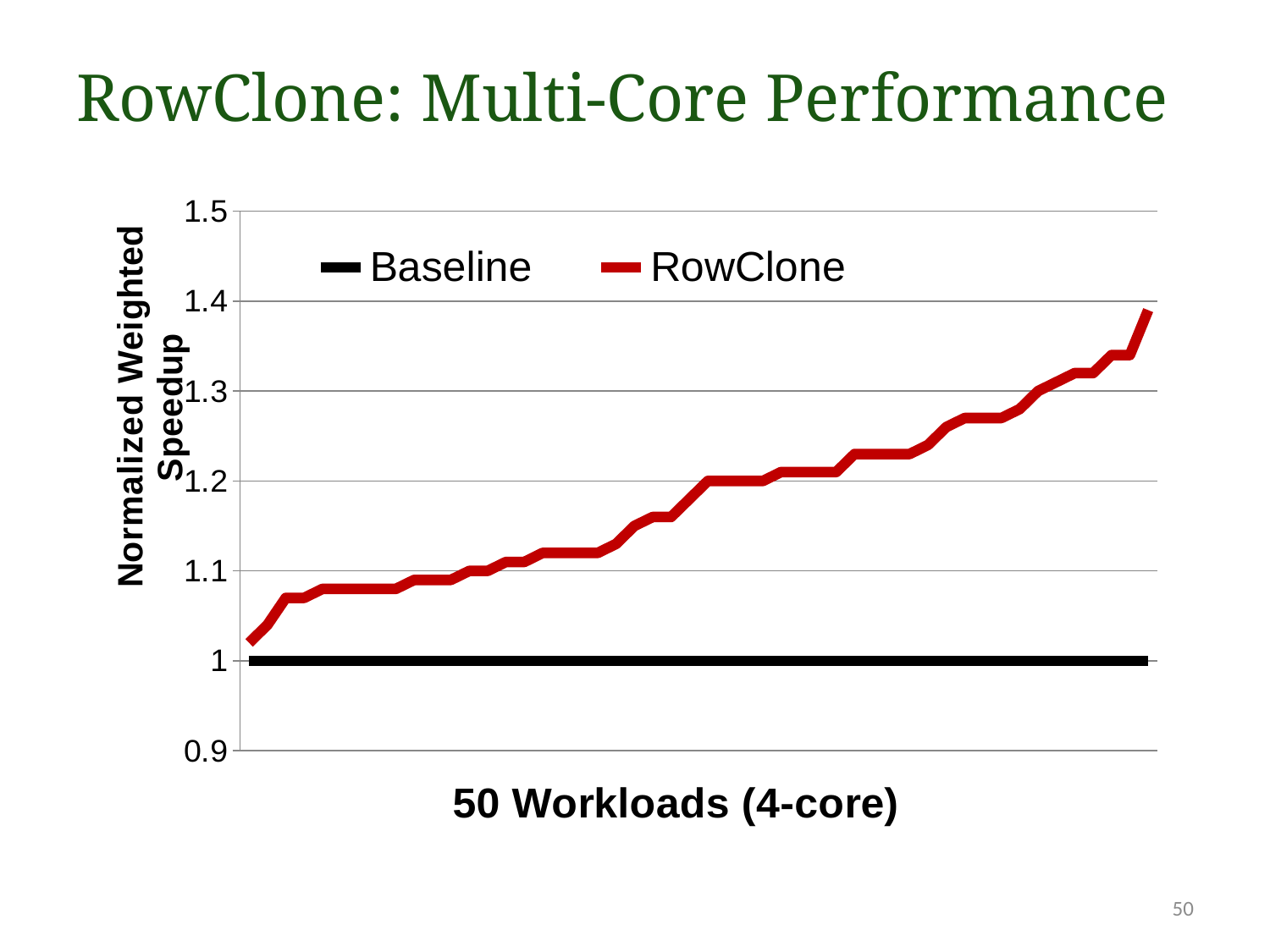
What is the title of the slide's chart? RowClone: Multi-Core Performance Is the lowest RowClone value greater or less than 1.1? less What kind of chart is shown on the slide? line chart Which series has the higher values across the workloads, Baseline or RowClone? RowClone What is the label on the x axis? 50 Workloads (4-core) Is the highest RowClone value greater or less than 1.3? greater Does the RowClone series rise or fall along the x axis? rise What is the normalized weighted speedup of the Baseline series across all workloads? 1 What are the two series named in the legend? Baseline and RowClone How many workloads are plotted along the x axis? 50 How many series does the legend list? 2